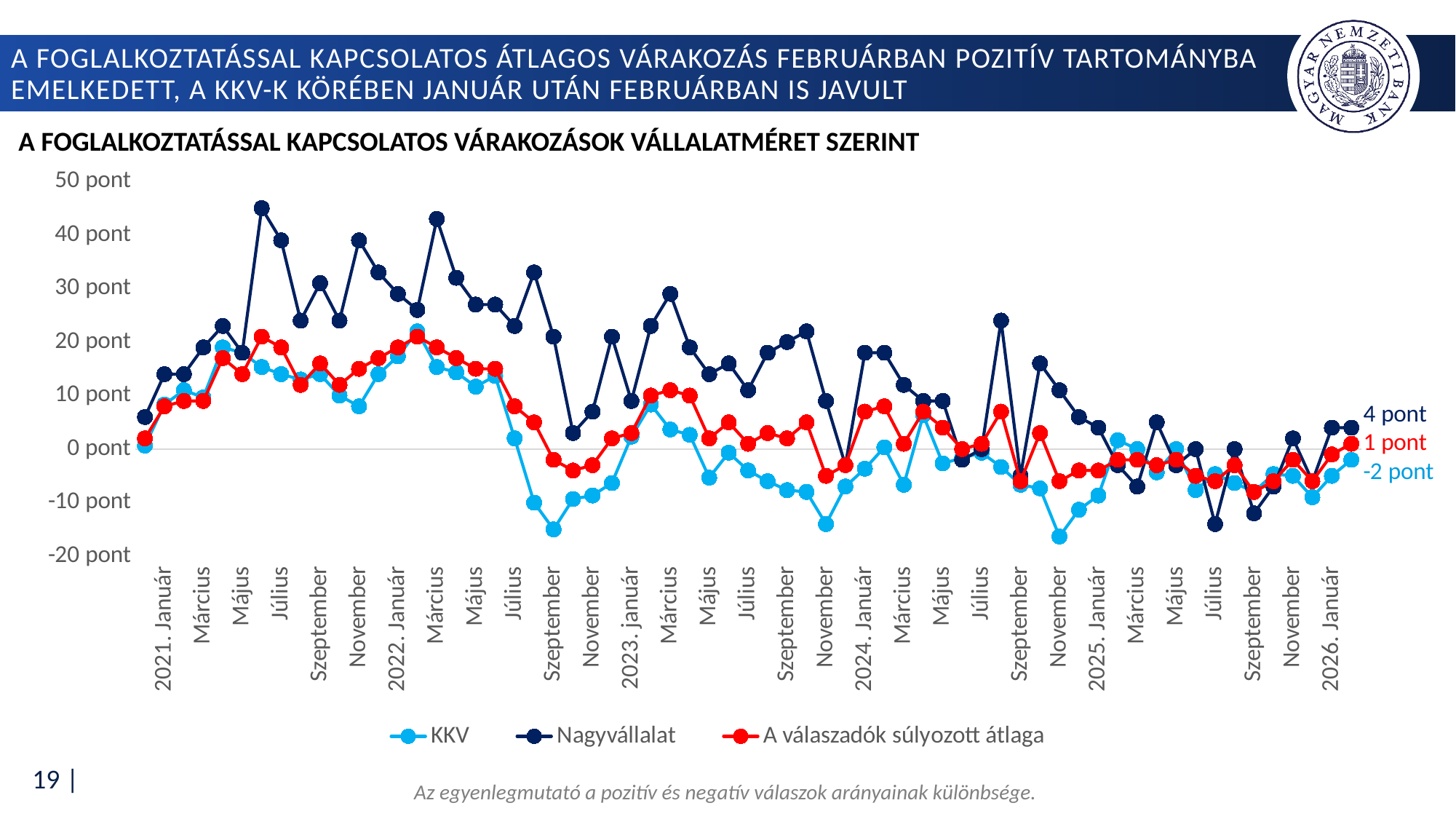
Is the peak value of the Nagyvállalat series in mid-2021 greater or less than 40 pont? greater Is the KKV value in September 2022 greater or less than -10 pont? less At the last data point, what is the difference between the Nagyvállalat value and the KKV value? 6 pont What type of chart is shown on the slide? line chart What is the latest (2026) value labelled for the KKV series? -2 pont How many series does the legend list? 3 What is the latest (2026) value labelled for the Nagyvállalat series? 4 pont What is the title of the chart? A foglalkoztatással kapcsolatos várakozások vállalatméret szerint What is the latest (2026) value labelled for 'A válaszadók súlyozott átlaga'? 1 pont At the last data point, which series is higher: Nagyvállalat or KKV? Nagyvállalat Which series reaches the highest value anywhere on the chart? Nagyvállalat Overall, does the Nagyvállalat series rise or fall from 2021 to 2026? fall